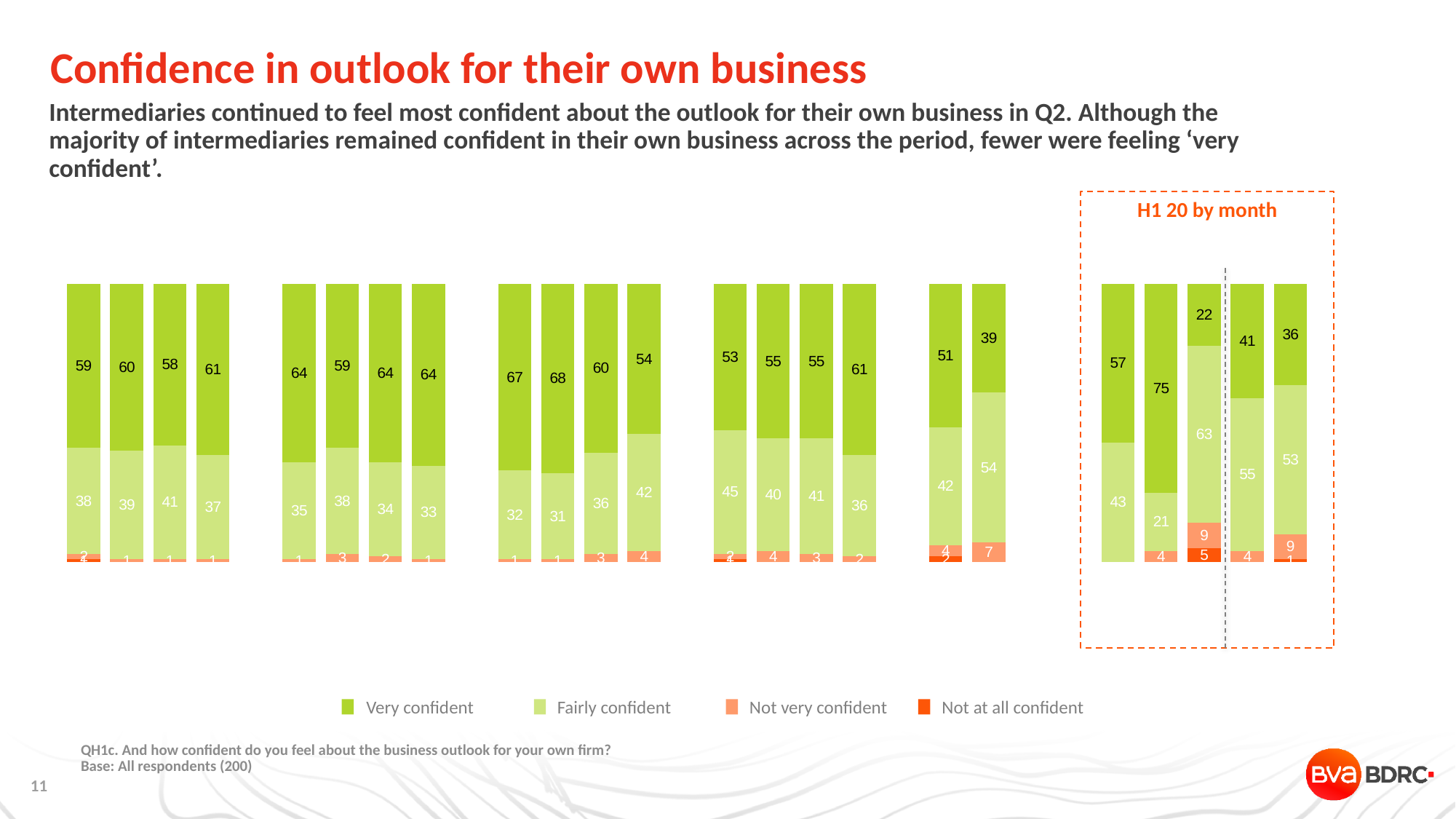
In the 'H1 20 by month' box, what is the Not at all confident value for the third bar? 5 What is the title of the slide containing the chart? Confidence in outlook for their own business In the 'H1 20 by month' box, what is the Not very confident value for the third bar? 9 How many bars are inside the dashed 'H1 20 by month' box? 5 In the 'H1 20 by month' box, which bar has the lowest Very confident value? The third bar (22) What kind of chart is shown on the slide? Stacked bar chart How many series does the chart legend list? 4 In the 'H1 20 by month' box, which bar has the highest Very confident value? The second bar (75) In the 'H1 20 by month' box, what is the difference between the Very confident values of the second bar (75) and the third bar (22)? 53 What are the four legend entries of the chart? Very confident, Fairly confident, Not very confident, Not at all confident In the 'H1 20 by month' box, is the Fairly confident value larger for the first bar or the third bar? The third bar (63) In the 'H1 20 by month' box, what is the Very confident value for the second bar? 75